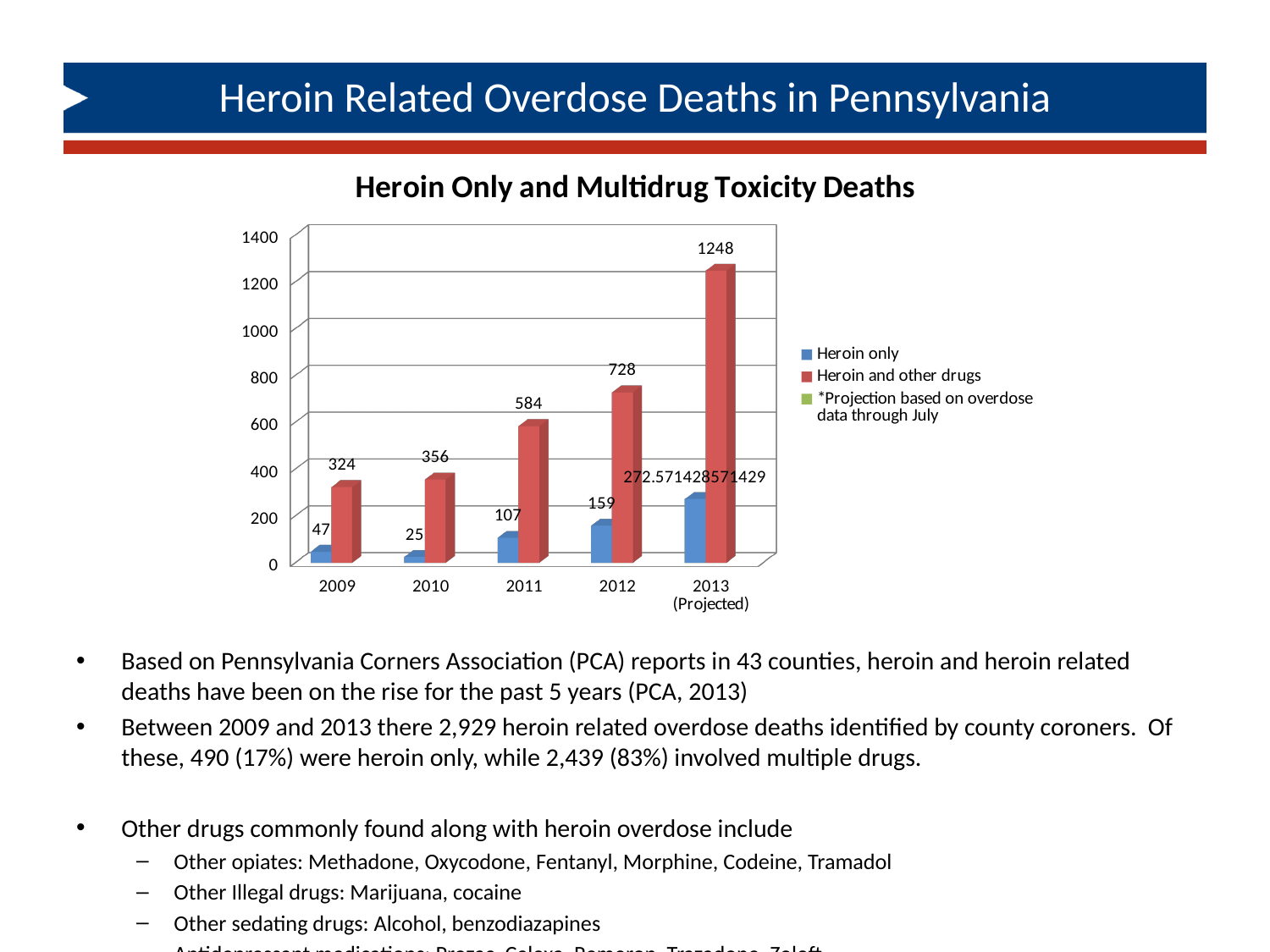
What is the value for Heroin and other drugs in 2013 (Projected)? 1248 Which year has the highest value for Heroin and other drugs? 2013 (Projected) How many years are shown on the x axis? 5 What is the value for Heroin and other drugs in 2011? 584 Which is larger in 2009: the Heroin only value or the Heroin and other drugs value? Heroin and other drugs What is the difference between the Heroin and other drugs values for 2012 and 2011? 144 Is the value for Heroin and other drugs in 2012 greater or less than 600? greater What is the value for Heroin only in 2010? 25 Do the Heroin and other drugs values rise or fall from 2009 to 2013 (Projected)? Rise What kind of chart is shown on the slide? Bar chart What is the value for Heroin only in 2012? 159 Which year has the lowest value for Heroin only? 2010